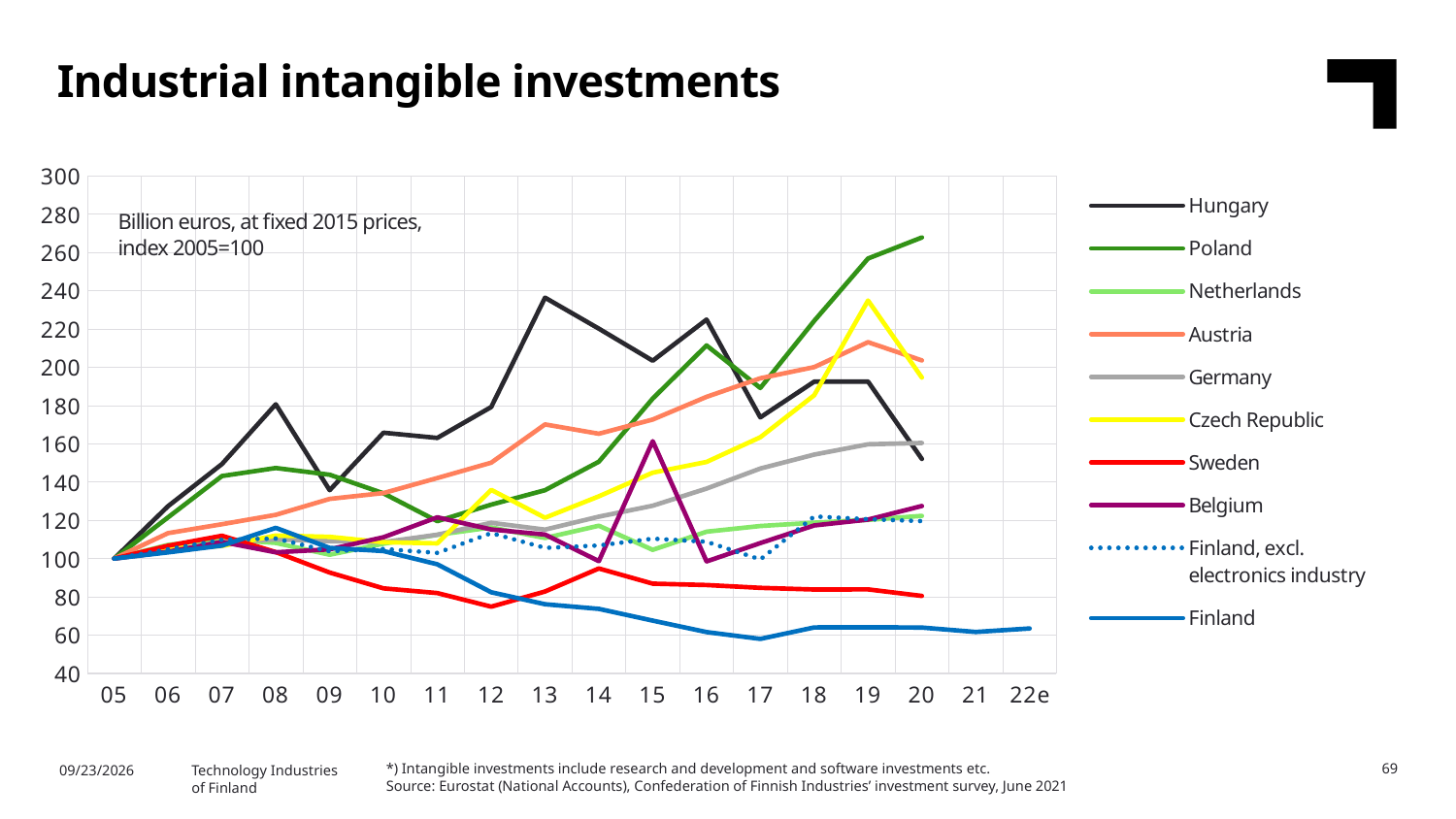
Does the Poland line rise or fall overall from 2005 to 2020? rise Which country has the highest value in 2020? Poland Which series is drawn with a dotted line? Finland, excl. electronics industry Is the value for Poland in 2020 greater or less than 240? greater Is the value for Hungary in 2013 greater or less than 220? greater Does the Finland line rise or fall overall from 2005 to 2020? fall Is the value for Finland in 2020 greater or less than 80? less Which series has the lowest value in 2020? Finland In 2020, which is larger, the value for Austria or the value for Germany? Austria How many series does the legend list? 10 What kind of chart is shown on the slide? line chart